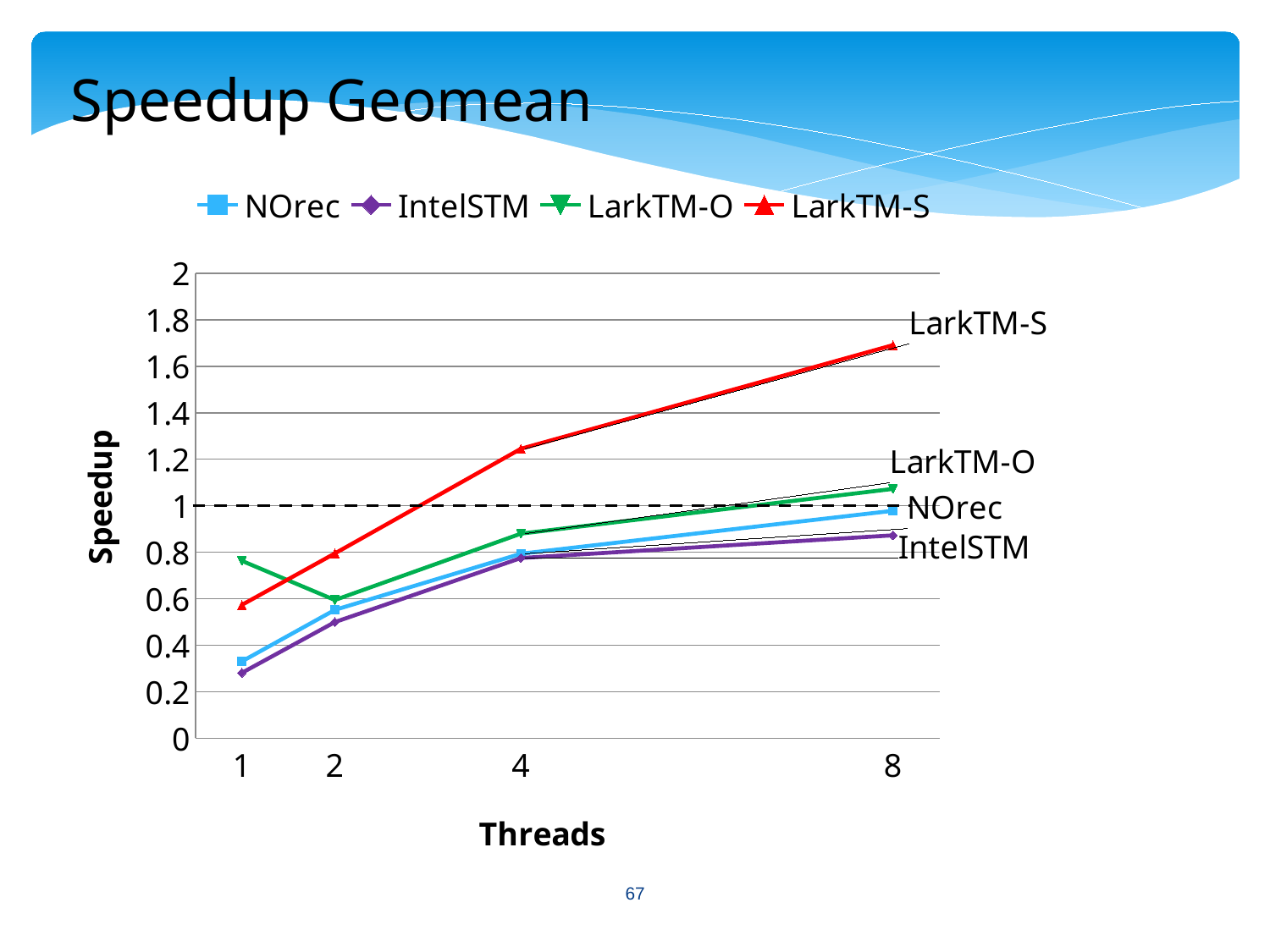
Which series has the highest speedup at 8 threads? LarkTM-S What kind of chart is shown on the slide? line chart Which series has the highest speedup at 1 thread? LarkTM-O Is the speedup for LarkTM-S at 8 threads greater or less than 1.6? greater Is the speedup for NOrec at 1 thread greater or less than 0.4? less What is the title of the x axis? Threads Does the speedup for LarkTM-S rise or fall as the number of threads increases? rise How many series does the legend list? 4 Is the speedup for IntelSTM at 8 threads greater or less than 1? less How many thread counts are plotted along the x axis? 4 At 1 thread, which has the larger speedup, LarkTM-O or LarkTM-S? LarkTM-O Which series has the lowest speedup at 8 threads? IntelSTM